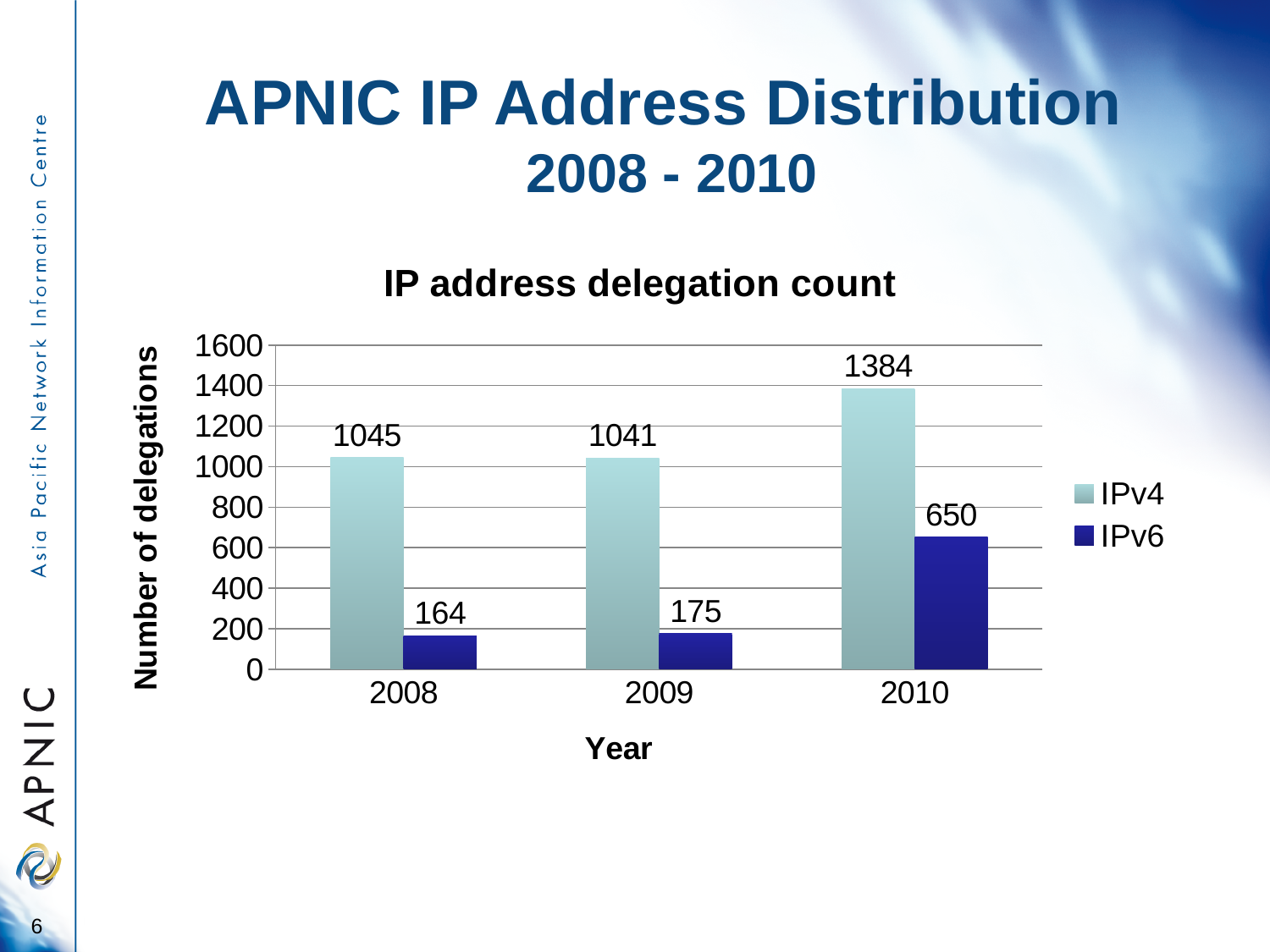
How many series does the legend list? 2 In which year is the IPv4 delegation count lowest? 2009 What is the IPv6 delegation count for 2008? 164 Which is larger, the IPv4 count in 2008 or the IPv4 count in 2010? IPv4 count in 2010 What is the IPv4 delegation count for 2010? 1384 What kind of chart is shown on the slide? Bar chart How many years are shown on the x axis? 3 What is the difference between the IPv4 and IPv6 delegation counts in 2010? 734 What is the IPv6 delegation count for 2009? 175 By how much did the IPv6 delegation count increase from 2009 to 2010? 475 In which year is the IPv6 delegation count highest? 2010 What is the title of the chart? IP address delegation count